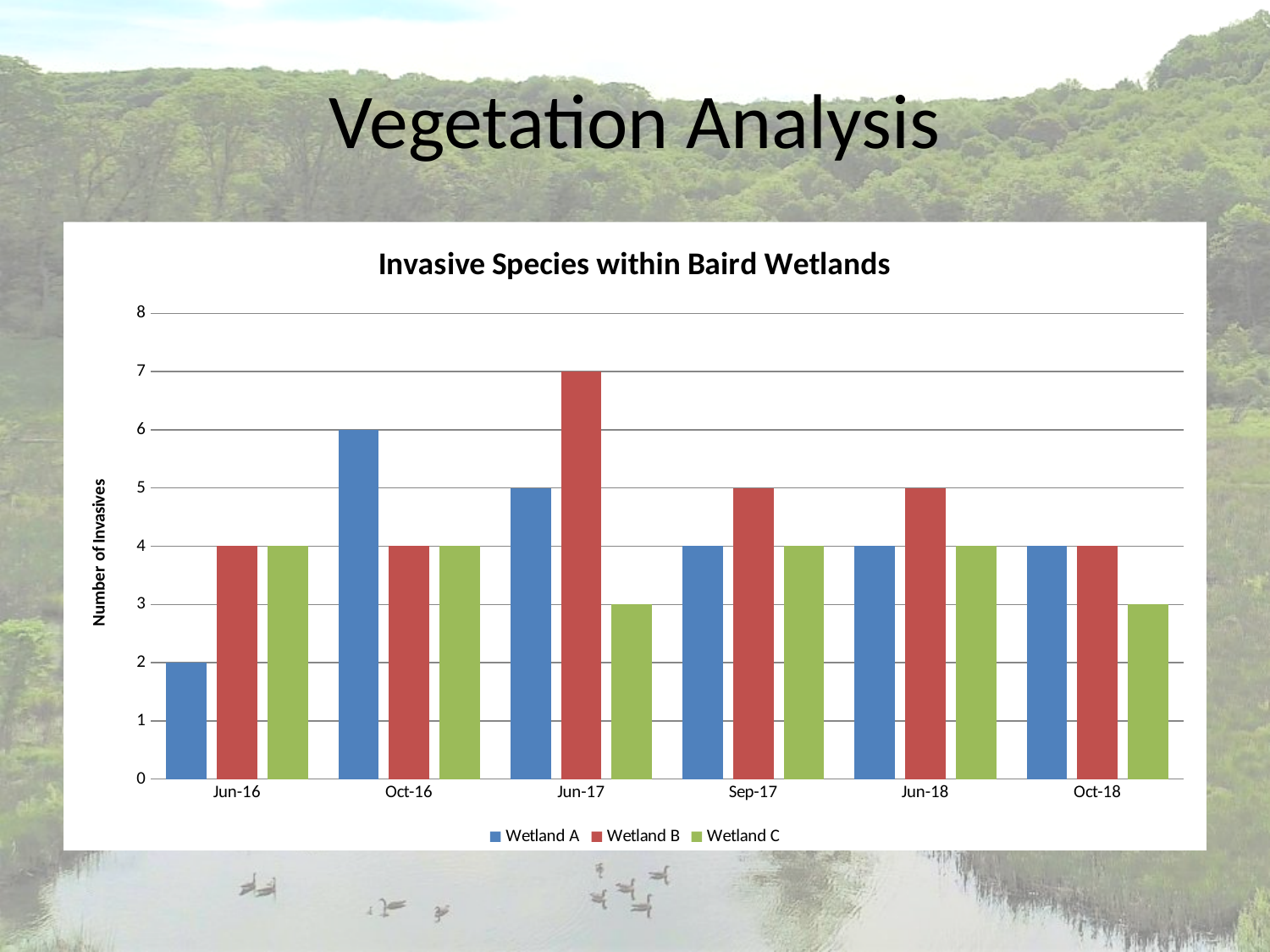
What is the number of invasives for Wetland A in Oct-16? 6 What is the number of invasives for Wetland B in Jun-17? 7 How many series does the legend list? 3 What is the title of the chart? Invasive Species within Baird Wetlands Which is larger in Oct-16, Wetland A or Wetland B? Wetland A What is the difference between Wetland B and Wetland C in Jun-17? 4 In which period does Wetland B have its highest number of invasives? Jun-17 In which period does Wetland A have its lowest number of invasives? Jun-16 How many time periods are shown on the x axis? 6 What is the number of invasives for Wetland A in Jun-16? 2 What is the label of the vertical axis? Number of Invasives What kind of chart is shown on the slide? Bar chart